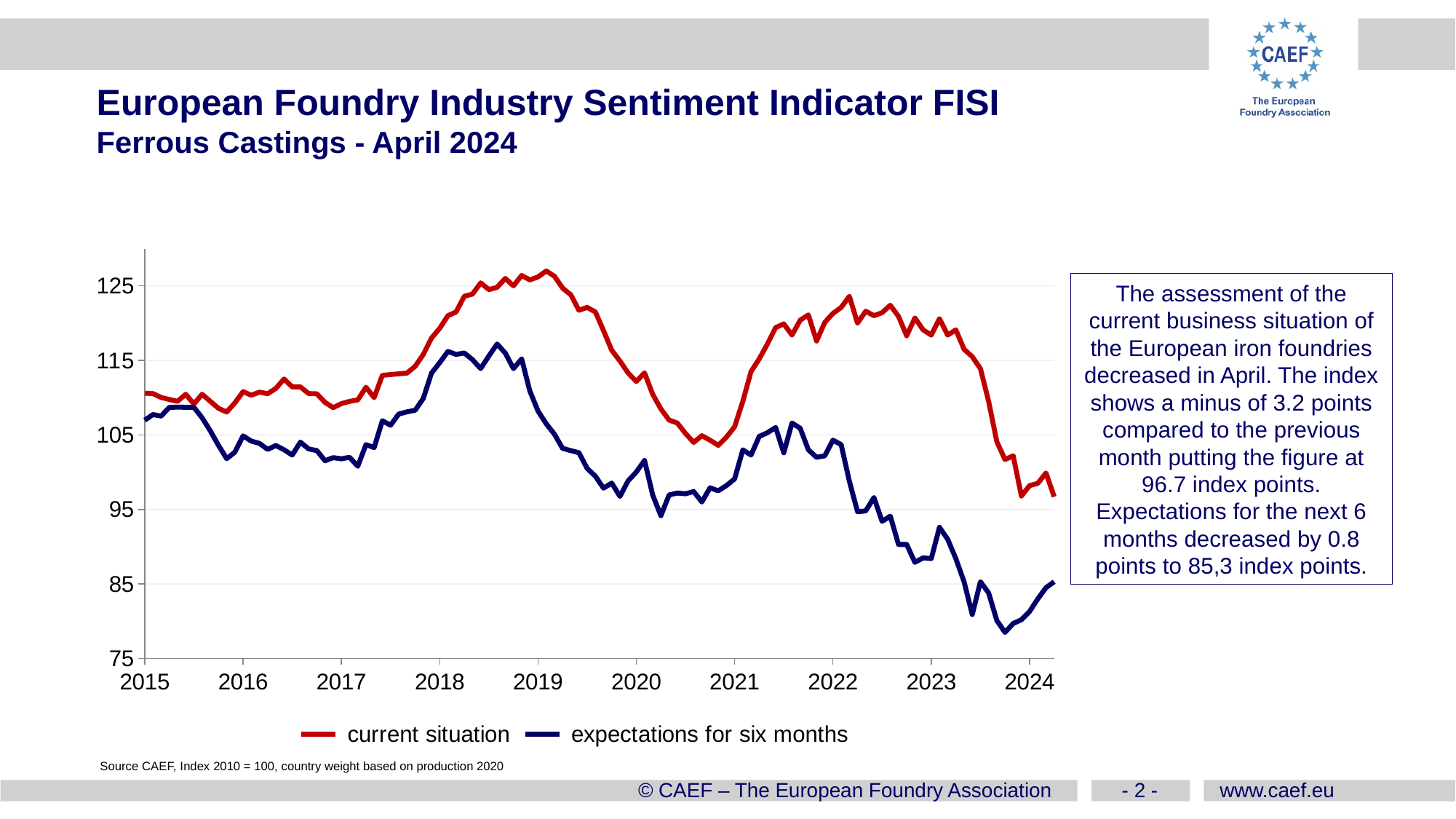
Which series is drawn in red on the chart? current situation Does the current situation line rise or fall between 2023 and 2024? fall Which series reaches the highest value anywhere on the chart? current situation According to the text box, what is the current situation index value for April 2024? 96.7 Does the current situation line rise or fall between 2017 and the start of 2019? rise Are the values of the expectations for six months line during 2020 greater or less than 105? less During 2022, which series has the higher values: current situation or expectations for six months? current situation How many series does the chart legend list? 2 Is the lowest point of the expectations for six months line in late 2023 greater or less than 85? less What are the two series named in the chart legend? current situation; expectations for six months Is the value of the current situation line at the start of 2019 greater or less than 115? greater What type of chart is shown on the slide? line chart